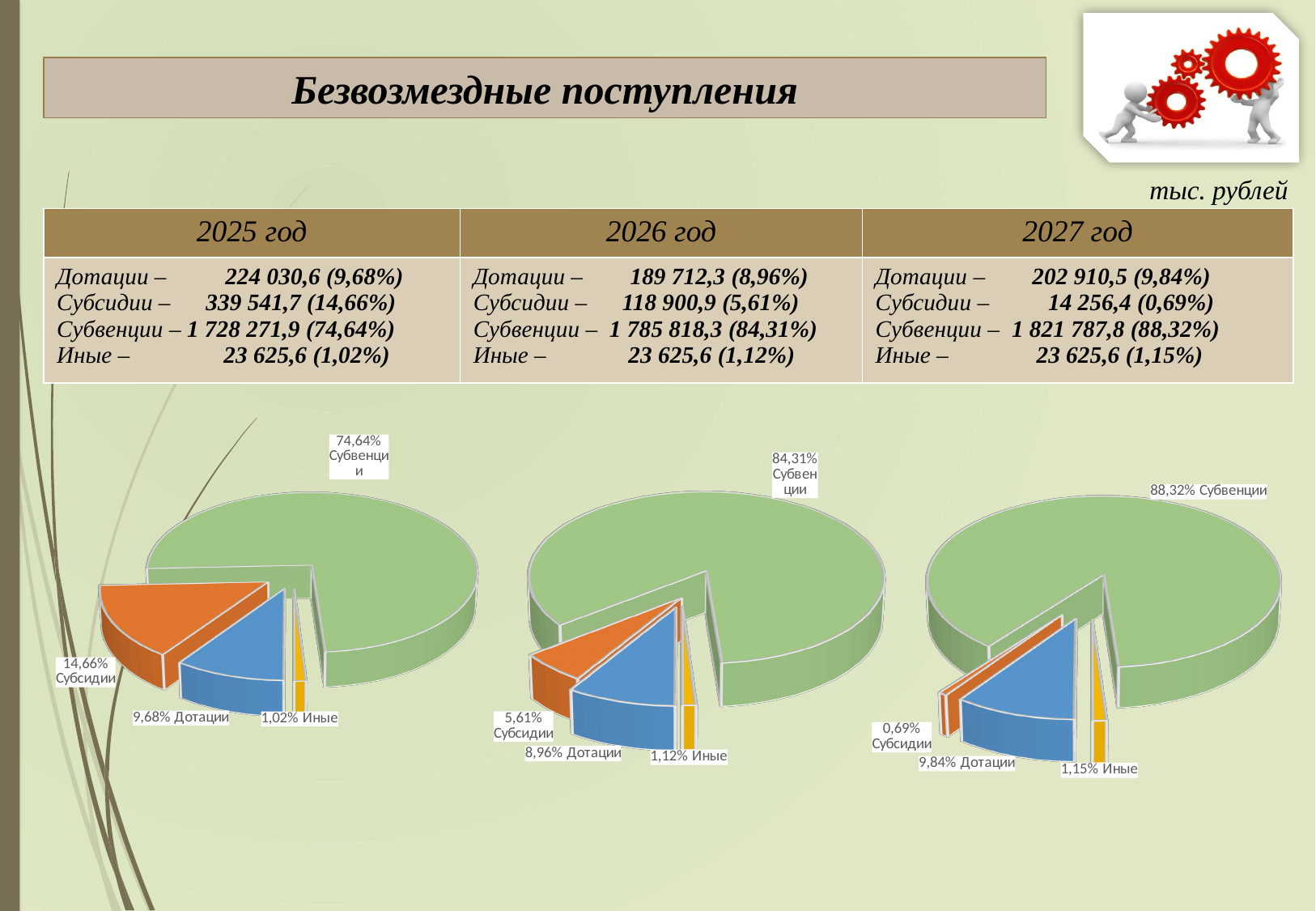
What colour is the Субвенции slice in the pie charts? Green In the right pie chart (2027), what share is labelled for Субсидии? 0,69% In the left pie chart (2025), what share is labelled for Субвенции? 74,64% What kind of chart is used on the slide to show the structure of gratuitous receipts? Pie chart What is the difference between the Субвенции share in the right pie chart (2027) and in the left pie chart (2025)? 13,68% How many slices does each pie chart on the slide have? 4 In the left pie chart (2025), which category has the smallest slice? Иные In the middle pie chart (2026), which category has the largest slice? Субвенции In the middle pie chart (2026), what share is labelled for Дотации? 8,96% In the right pie chart (2027), what share is labelled for Иные? 1,15% In the left pie chart (2025), which slice is larger: Субсидии or Дотации? Субсидии In the left pie chart (2025), what share is labelled for Субсидии? 14,66%